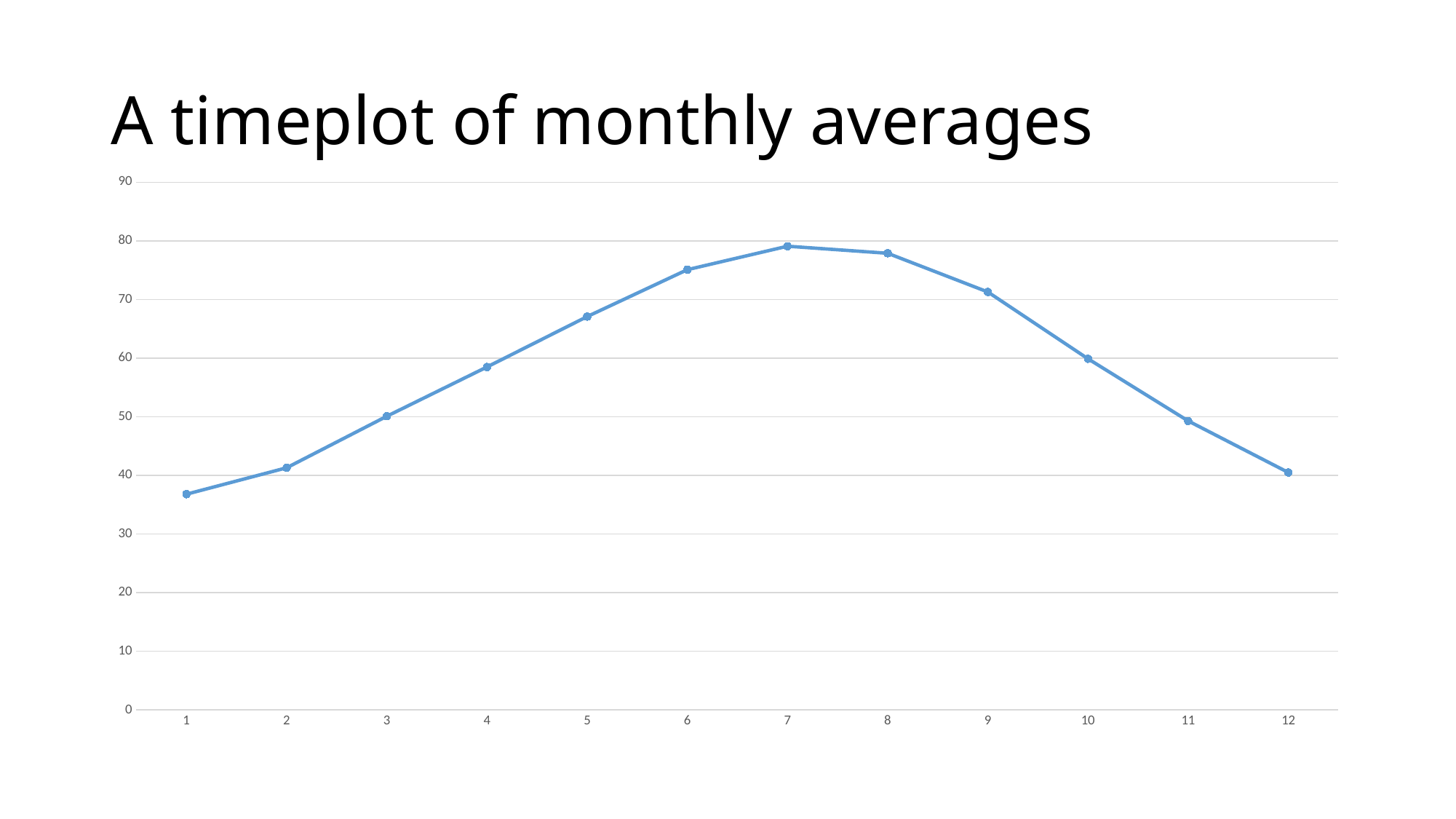
Which is larger, the value for month 2 or the value for month 11? month 11 Which month has the lowest value? 1 Which is larger, the value for month 6 or the value for month 10? month 6 Which month has the highest value? 7 What is the title of the chart on the slide? A timeplot of monthly averages Is the value for month 5 greater or less than 60? greater How many data points are plotted on the line? 12 Do the values rise or fall from month 7 to month 12? fall Is the value for month 6 greater or less than 70? greater Is the value for month 12 greater or less than 50? less What kind of chart is shown on the slide? line chart